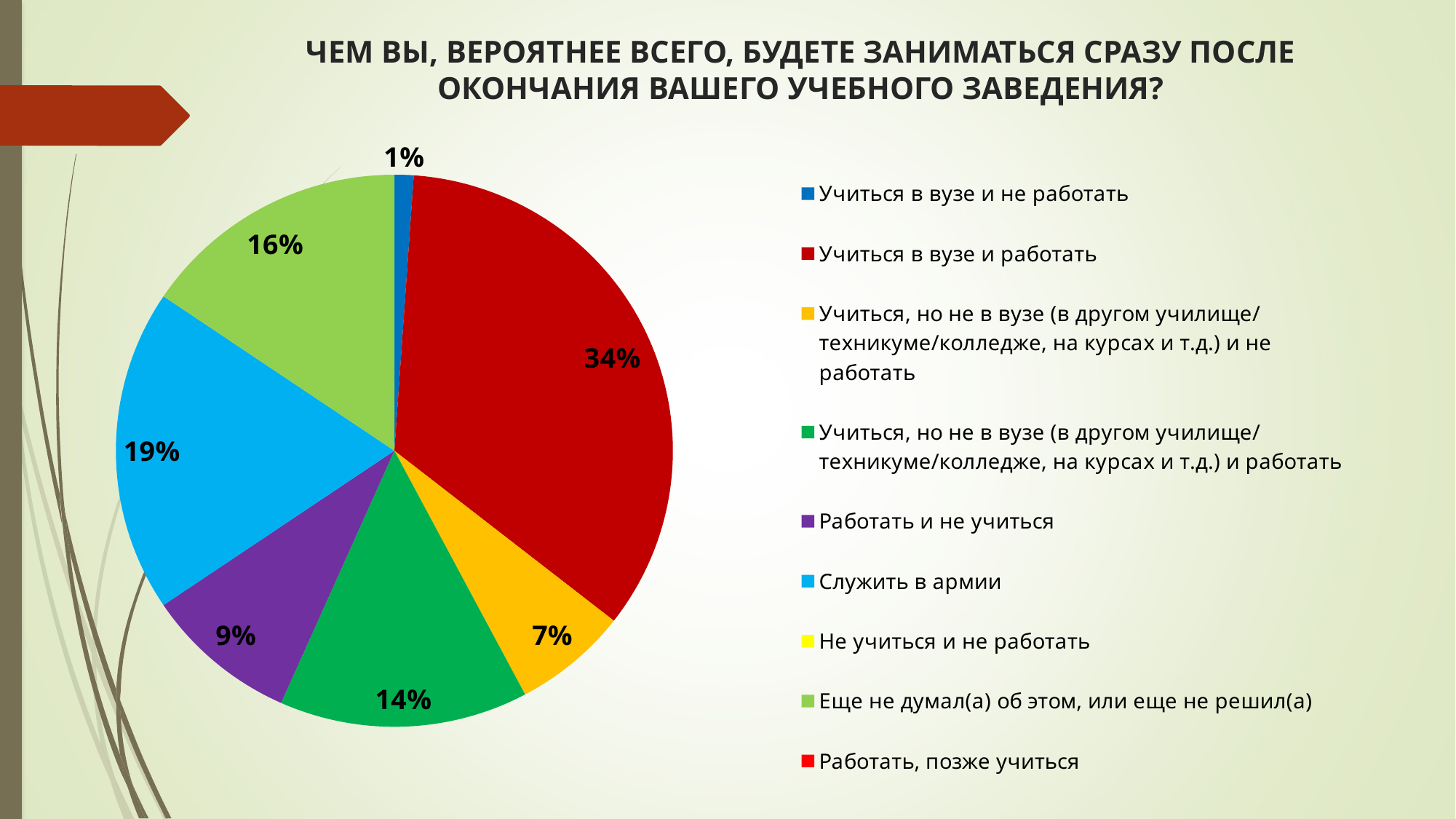
What is the difference between the share for "Служить в армии" and the share for "Работать и не учиться"? 10% What colour is the slice for "Служить в армии"? light blue What share of respondents chose "Учиться в вузе и не работать"? 1% Which is larger: the share for "Учиться, но не в вузе ... и работать" or the share for "Учиться, но не в вузе ... и не работать"? Учиться, но не в вузе ... и работать Which category has the largest slice of the pie? Учиться в вузе и работать What share of respondents chose "Еще не думал(а) об этом, или еще не решил(а)"? 16% Which labelled slice of the pie is the smallest? Учиться в вузе и не работать What share of respondents chose "Учиться в вузе и работать"? 34% What share of respondents chose "Служить в армии"? 19% What share of respondents chose "Работать и не учиться"? 9% How many entries does the legend list? 9 What kind of chart is shown on the slide? pie chart